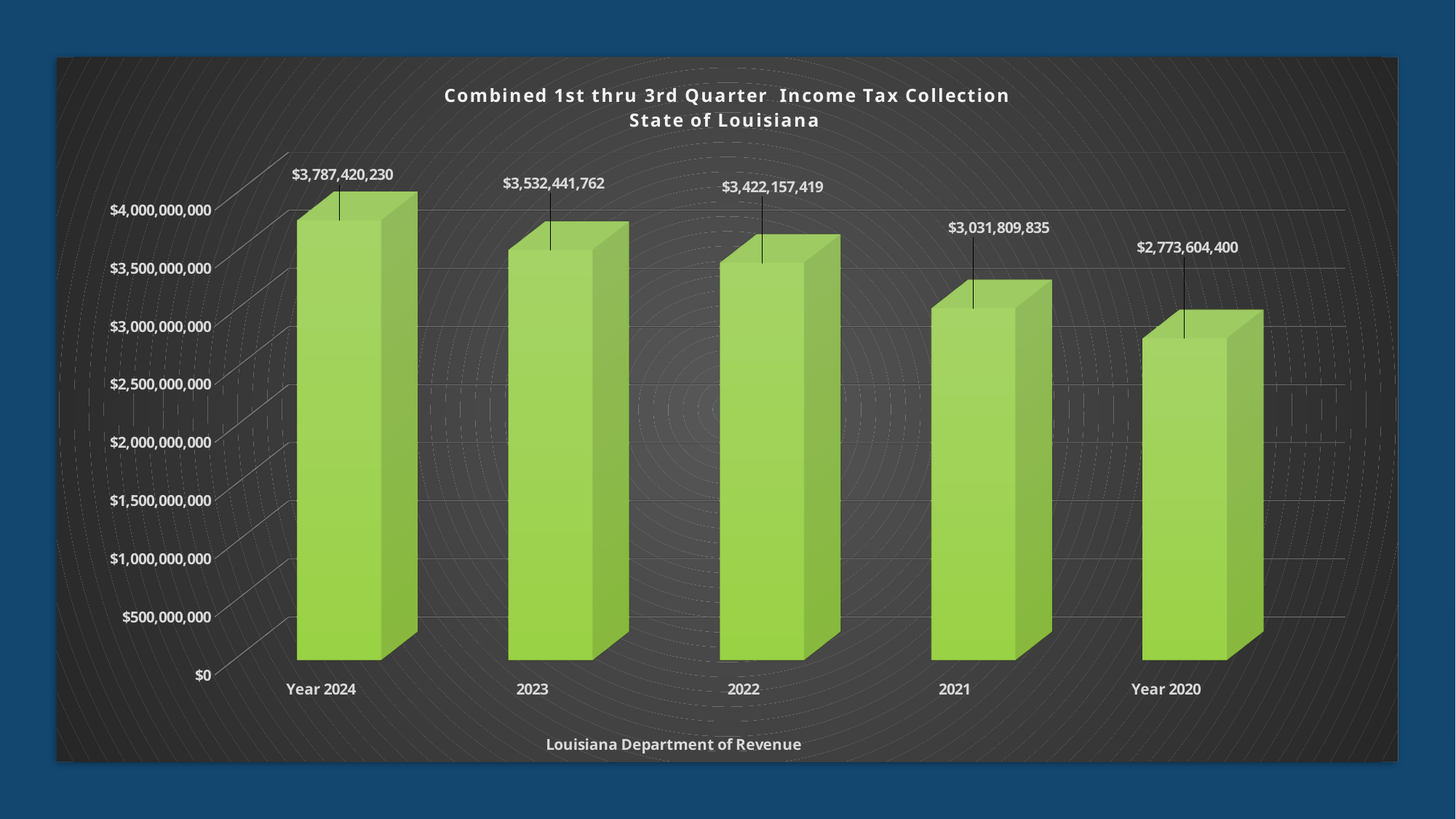
What is the difference between the values for Year 2024 and 2023? $254,978,468 What kind of chart is shown on the slide? bar chart Which year has the highest income tax collection? Year 2024 Is the value for 2021 greater or less than $3,500,000,000? less What is the value for Year 2020? $2,773,604,400 Do the values rise or fall moving left to right along the x axis from Year 2024 to Year 2020? fall What is the difference between the values for 2021 and Year 2020? $258,205,435 What is the value for 2022? $3,422,157,419 Which year has the lowest income tax collection? Year 2020 How many years are shown on the chart? 5 What is the value for Year 2024? $3,787,420,230 Which is larger, the value for 2023 or the value for 2022? 2023